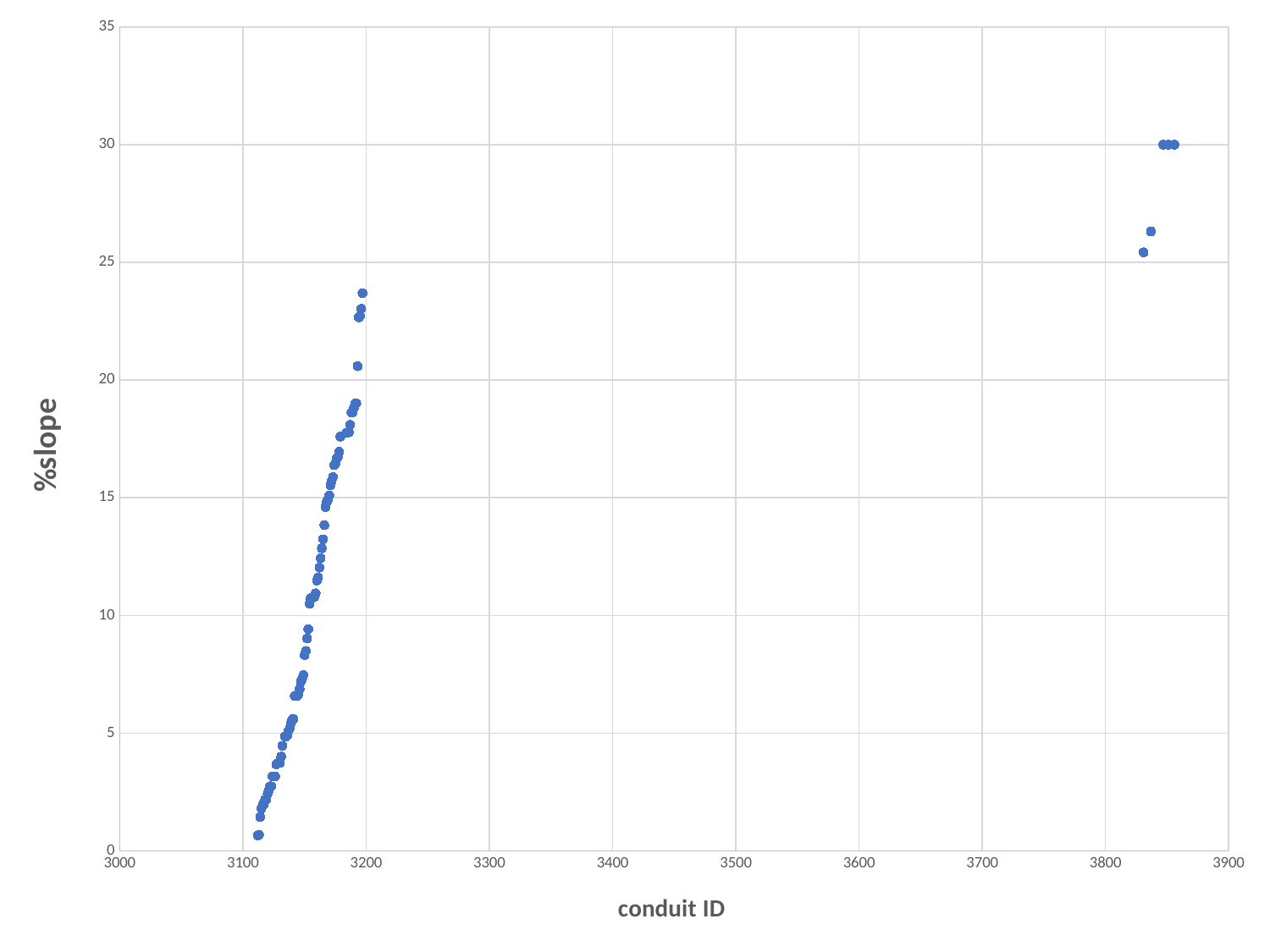
Is the %slope of the highest point in the cluster near conduit ID 3200 greater or less than 20? greater What is the label of the horizontal axis? conduit ID Is the %slope of the lowest point on the chart greater or less than 5? less What kind of chart is shown on the slide? scatter chart Is the highest %slope among the points between conduit ID 3100 and 3200 greater or less than 25? less Within the cluster of points between conduit ID 3100 and 3200, do the %slope values rise or fall as conduit ID increases? rise What is the label of the vertical axis? %slope Which group of points has higher %slope values: those near conduit ID 3850 or those near conduit ID 3150? those near conduit ID 3850